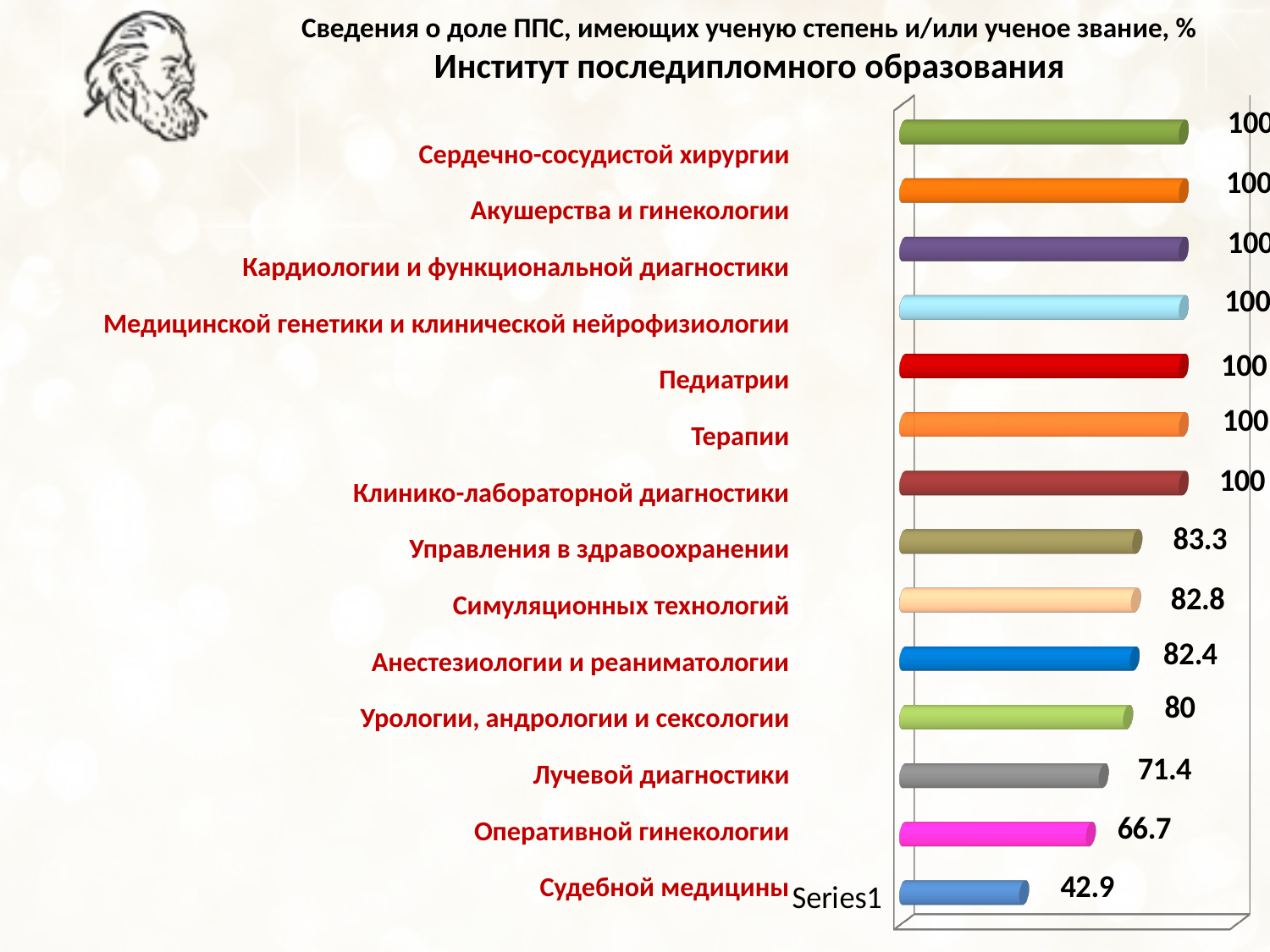
What is the difference between the values for Педиатрии and Анестезиологии и реаниматологии? 17.6 What type of chart is shown on the slide? bar chart What is the difference between the values for Оперативной гинекологии and Судебной медицины? 23.8 What is the name of the series shown at the bottom of the chart? Series1 Which is larger, the value for Симуляционных технологий or the value for Лучевой диагностики? Симуляционных технологий What is the value for Судебной медицины? 42.9 How many categories have a value of 100? 7 Which category has the lowest value in the chart? Судебной медицины What is the value for Урологии, андрологии и сексологии? 80 How many categories (departments) are plotted in the chart? 14 What is the value for Лучевой диагностики? 71.4 What is the value for Управления в здравоохранении? 83.3